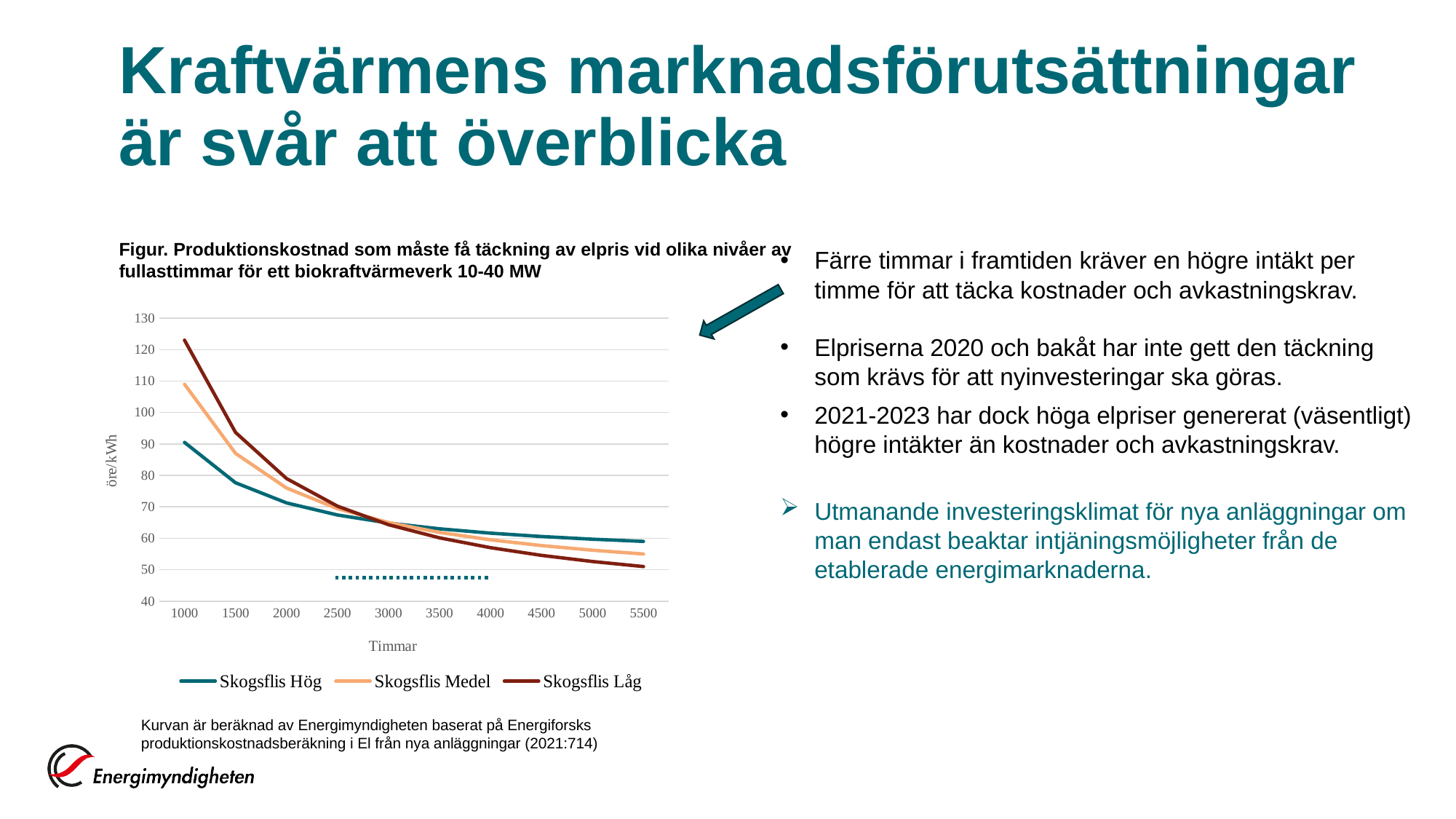
Do the values of the Skogsflis Låg series rise or fall as the number of hours (Timmar) increases? fall What kind of chart is shown on the slide? line chart What is the label of the x axis of the chart? Timmar Which series has the highest value at 1000 hours? Skogsflis Låg How many series does the chart legend list? 3 Which series has the highest value at 5500 hours? Skogsflis Hög Is the value for Skogsflis Låg at 1000 hours greater or less than 110? greater Is the value for Skogsflis Medel at 5500 hours greater or less than 60? less Which series has the lowest value at 5500 hours? Skogsflis Låg How many points are shown along the x axis (Timmar) of the chart? 10 What is the label of the y axis of the chart? öre/kWh Is the value for Skogsflis Hög at 1000 hours greater or less than 100? less